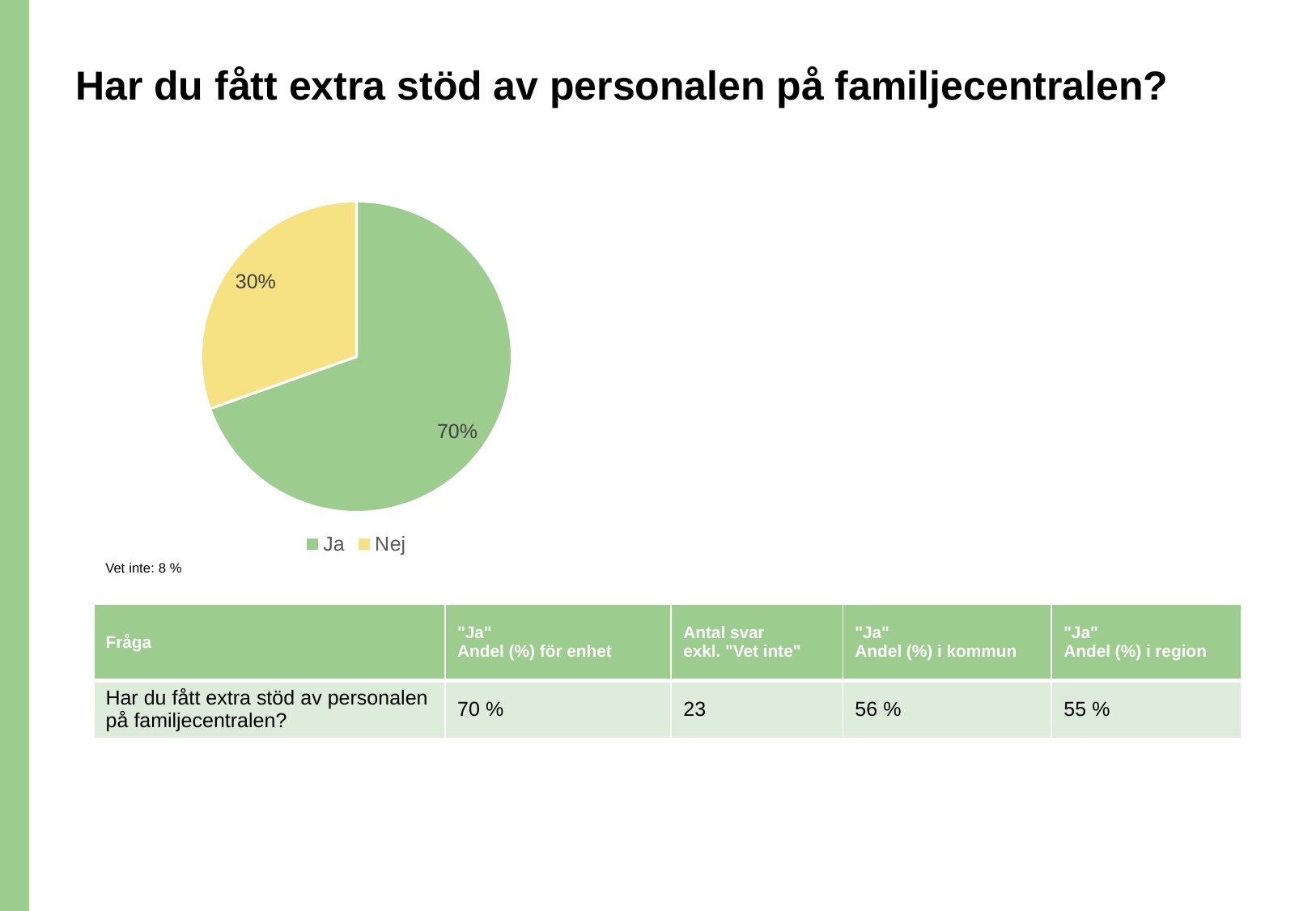
How many entries does the legend list? 2 How many slices does the pie chart have? 2 What share of the pie does "Ja" represent? 70% Which slice of the pie is the smallest? Nej What is the difference in percentage points between the "Ja" and "Nej" slices? 40 What kind of chart is shown on the slide? pie chart What percentage is given for "Vet inte" below the pie chart? 8 % Which is larger, the "Ja" slice or the "Nej" slice? Ja Is the share of the "Ja" slice greater or less than 50%? greater What colour is the "Nej" slice in the pie chart? yellow What share of the pie does "Nej" represent? 30% Which slice of the pie is the largest? Ja